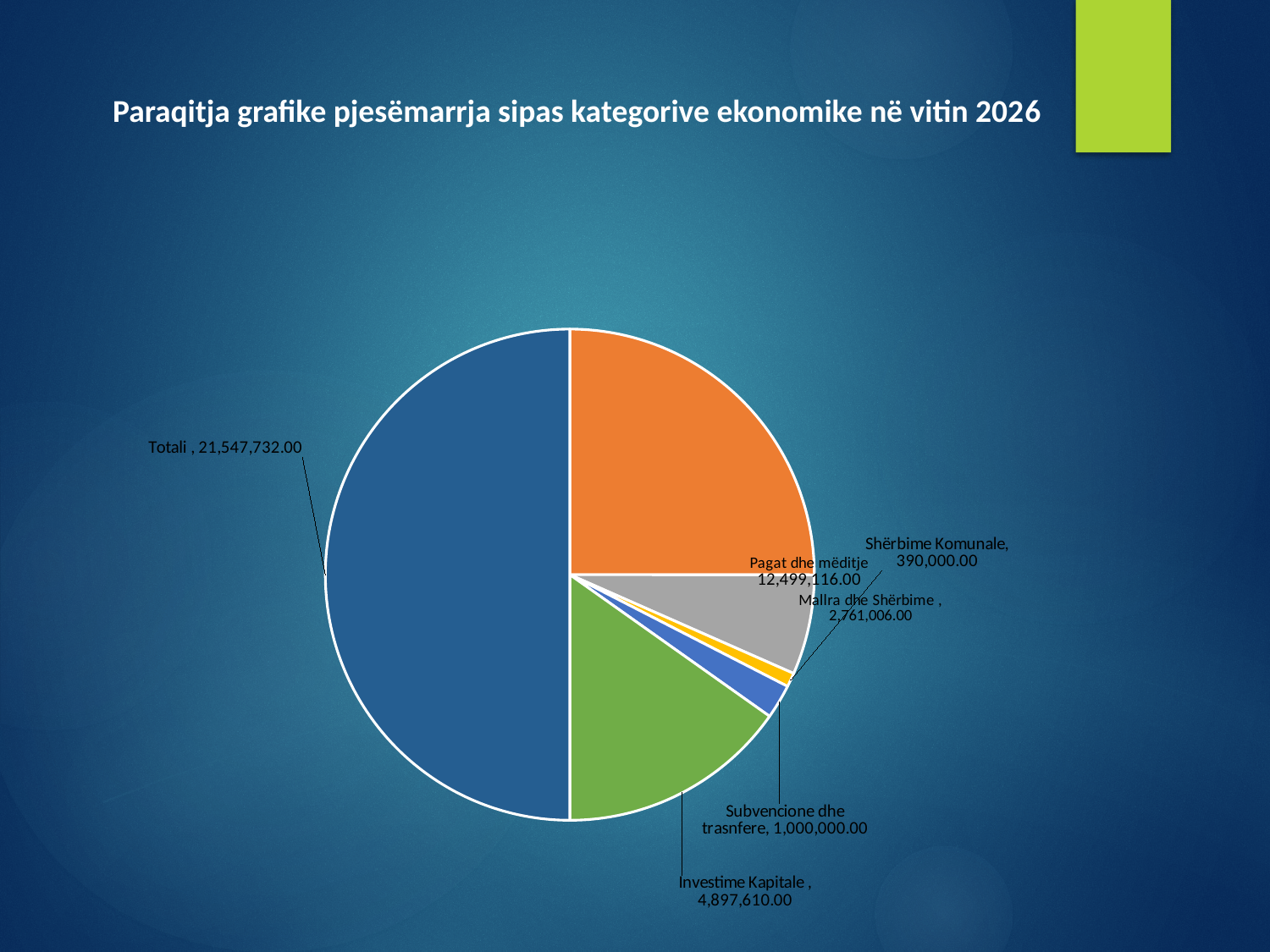
What is the value shown for Investime Kapitale? 4,897,610.00 Which is larger, Investime Kapitale or Mallra dhe Shërbime? Investime Kapitale What type of chart is shown on the slide? Pie chart What is the value shown for Mallra dhe Shërbime? 2,761,006.00 What is the value shown for Shërbime Komunale? 390,000.00 What is the difference between the values for Pagat dhe mëditje and Investime Kapitale? 7,601,506.00 Which slice of the pie has the smallest value? Shërbime Komunale What is the value shown for Pagat dhe mëditje? 12,499,116.00 Which slice of the pie has the largest value? Totali What is the value shown for Subvencione dhe trasnfere? 1,000,000.00 What is the title of the chart on the slide? Paraqitja grafike pjesëmarrja sipas kategorive ekonomike në vitin 2026 How many slices does the pie chart have? 6